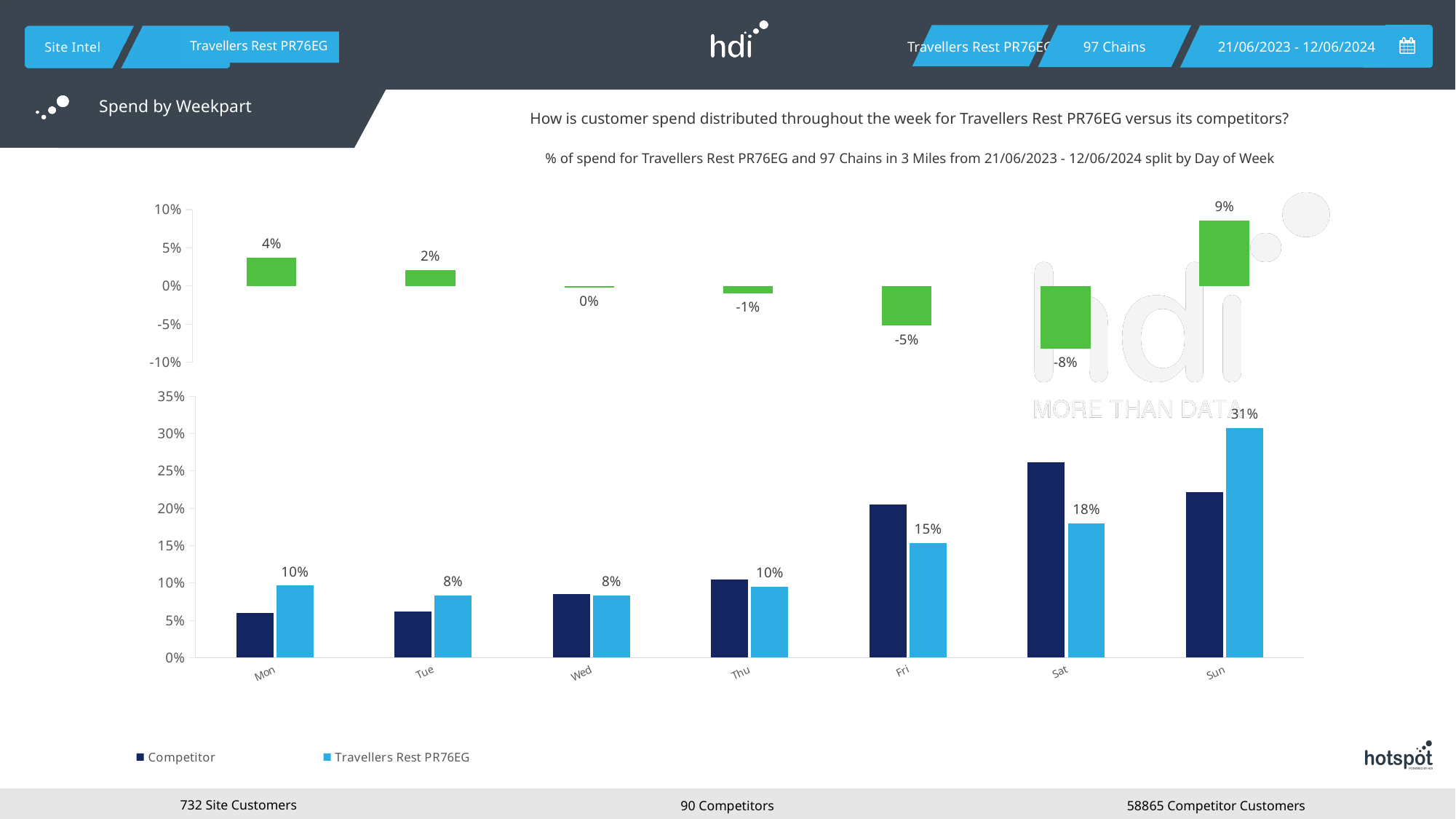
In the top chart, what is the value for Sat? -8% In the top chart, which day has the lowest value? Sat In the top chart, which day has the highest value? Sun In the bottom chart, on which day is the Travellers Rest PR76EG value highest? Sun What kind of chart is the bottom chart? bar chart In the bottom chart, what is the value for Travellers Rest PR76EG on Fri? 15% In the bottom chart, is the Competitor value for Sat greater or less than 20%? greater In the bottom chart, which is larger on Mon: the Competitor value or the Travellers Rest PR76EG value? Travellers Rest PR76EG In the bottom chart, how many days of the week are shown on the x axis? 7 In the bottom chart, how many series does the legend list? 2 In the bottom chart, what is the difference between the Travellers Rest PR76EG values for Sat and Fri? 3% In the bottom chart, what is the value for Travellers Rest PR76EG on Sun? 31%